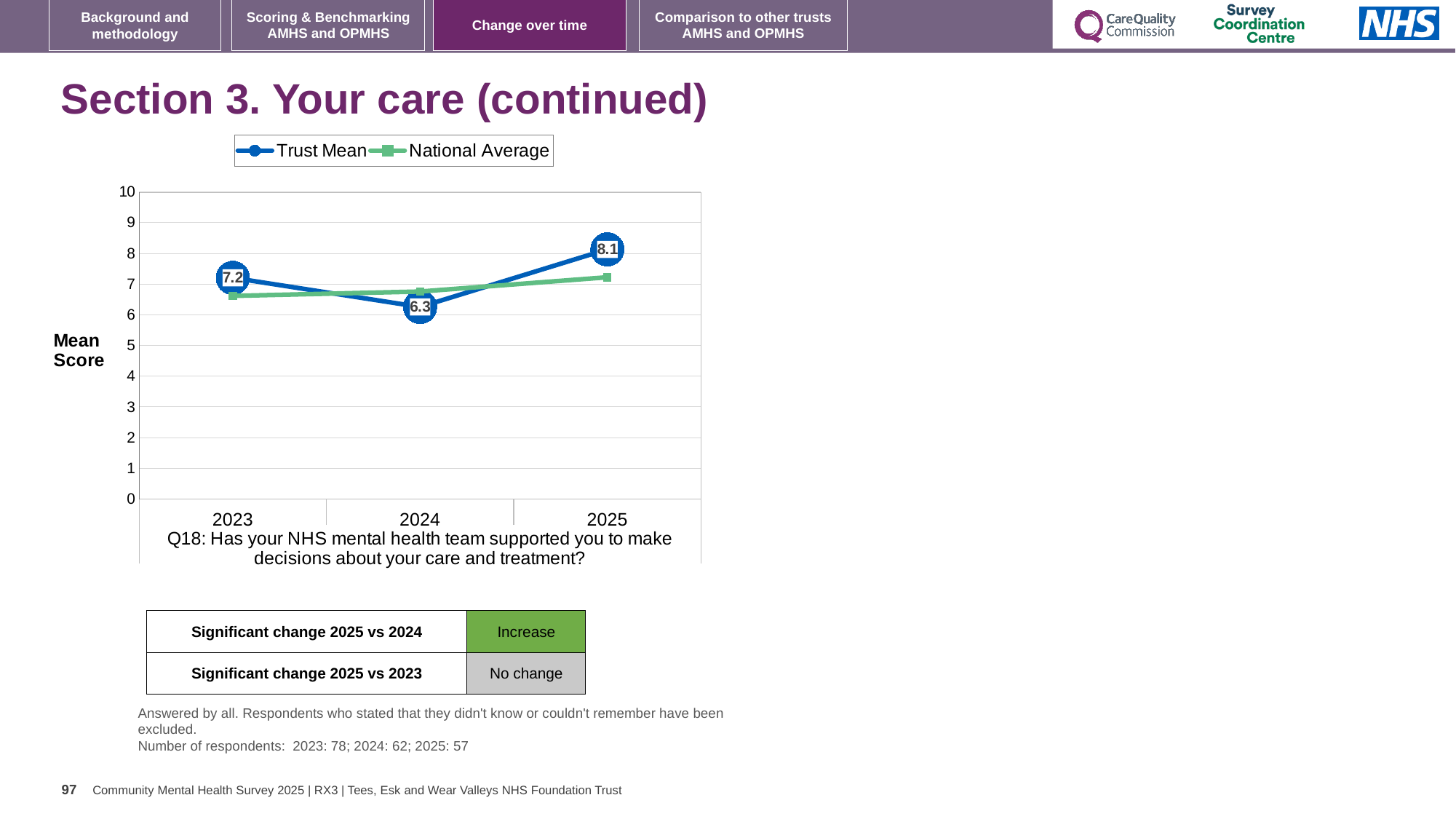
In which year is the Trust Mean lowest? 2024 In which year is the Trust Mean highest? 2025 Is the National Average for 2025 greater or less than 8? less What is the Trust Mean score for 2025? 8.1 How many years are shown on the x axis? 3 What is the difference between the Trust Mean in 2025 and in 2024? 1.8 How many series does the legend list? 2 What is the Trust Mean score for 2024? 6.3 What kind of chart is shown on the slide? line chart What is the Trust Mean score for 2023? 7.2 Which is larger, the Trust Mean in 2023 or in 2024? 2023 Does the Trust Mean rise or fall from 2024 to 2025? rise